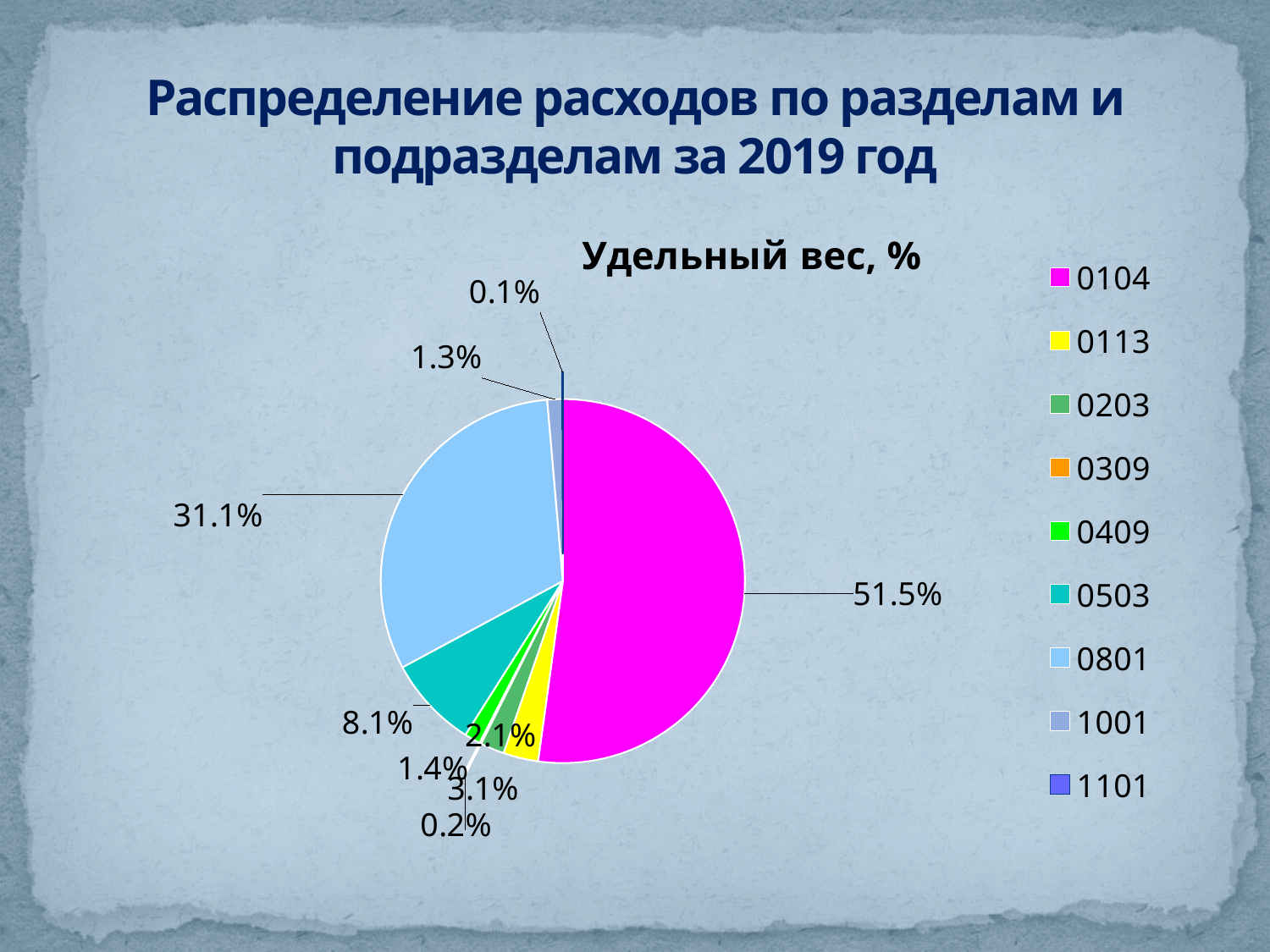
Which is larger, the value for 0801 or the value for 0503? 0801 What share of the pie does category 0104 have? 51.5% How many categories does the legend list? 9 What kind of chart is shown on the slide? pie chart What is the value for category 0801? 31.1% Which category has the smallest slice of the pie? 1101 Which category has the largest slice of the pie? 0104 What is the value for category 1001? 1.3% What is the value for category 0503? 8.1% What is the title of the chart? Удельный вес, % What is the difference between the values for 0104 and 0801? 20.4 percentage points What is the value for category 1101? 0.1%